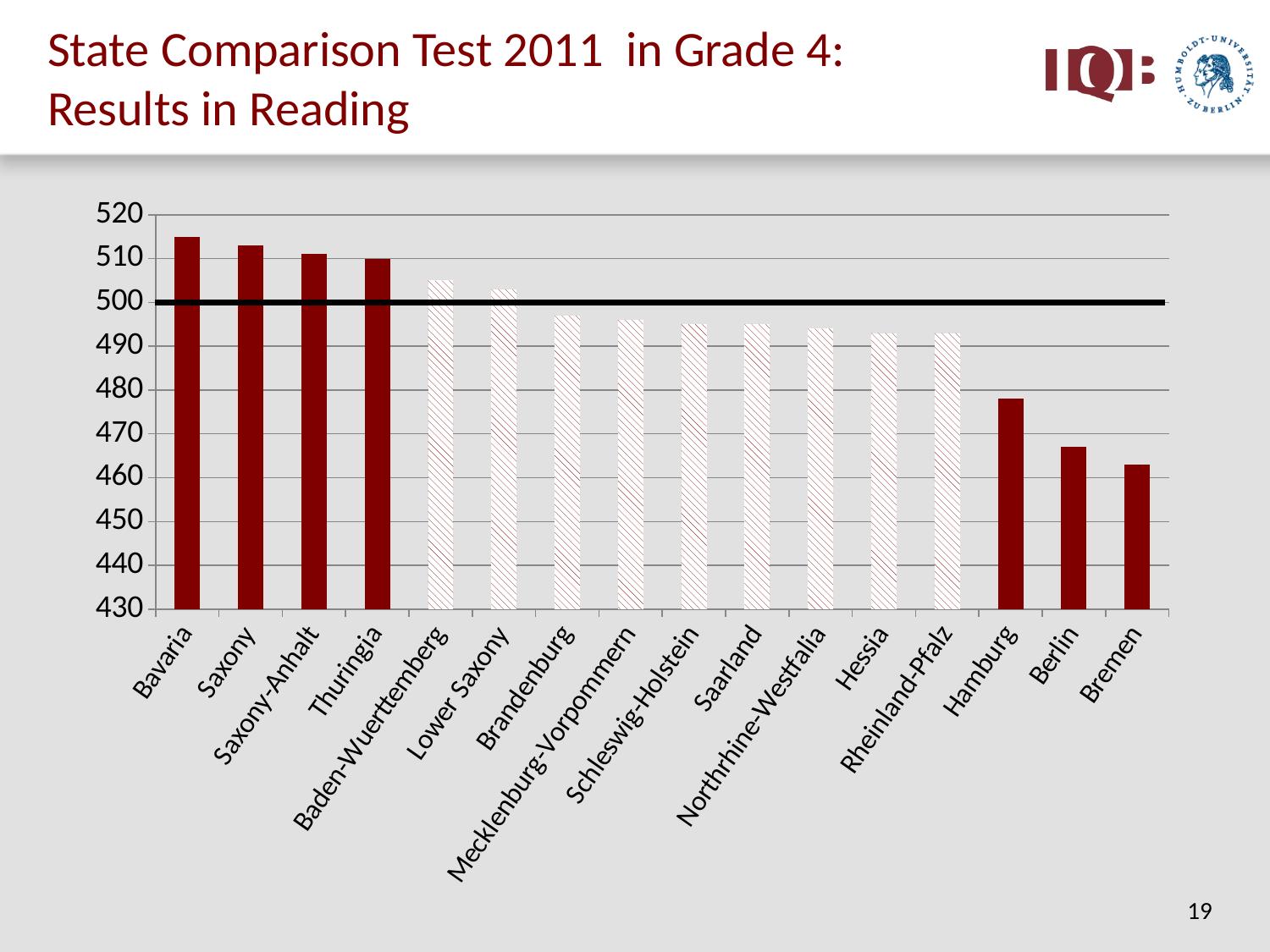
Is the value for Hamburg greater or less than 480? less Which state has the highest reading result in the chart? Bavaria Which state has the lowest reading result in the chart? Bremen What kind of chart is shown on the slide? bar chart Is the value for Bremen greater or less than 460? greater Do the values rise or fall from left to right along the x axis? fall At what value on the y axis is the horizontal black reference line drawn? 500 Which has the larger value, Hamburg or Berlin? Hamburg Is the value for Brandenburg greater or less than 500? less How many states are shown on the x axis of the chart? 16